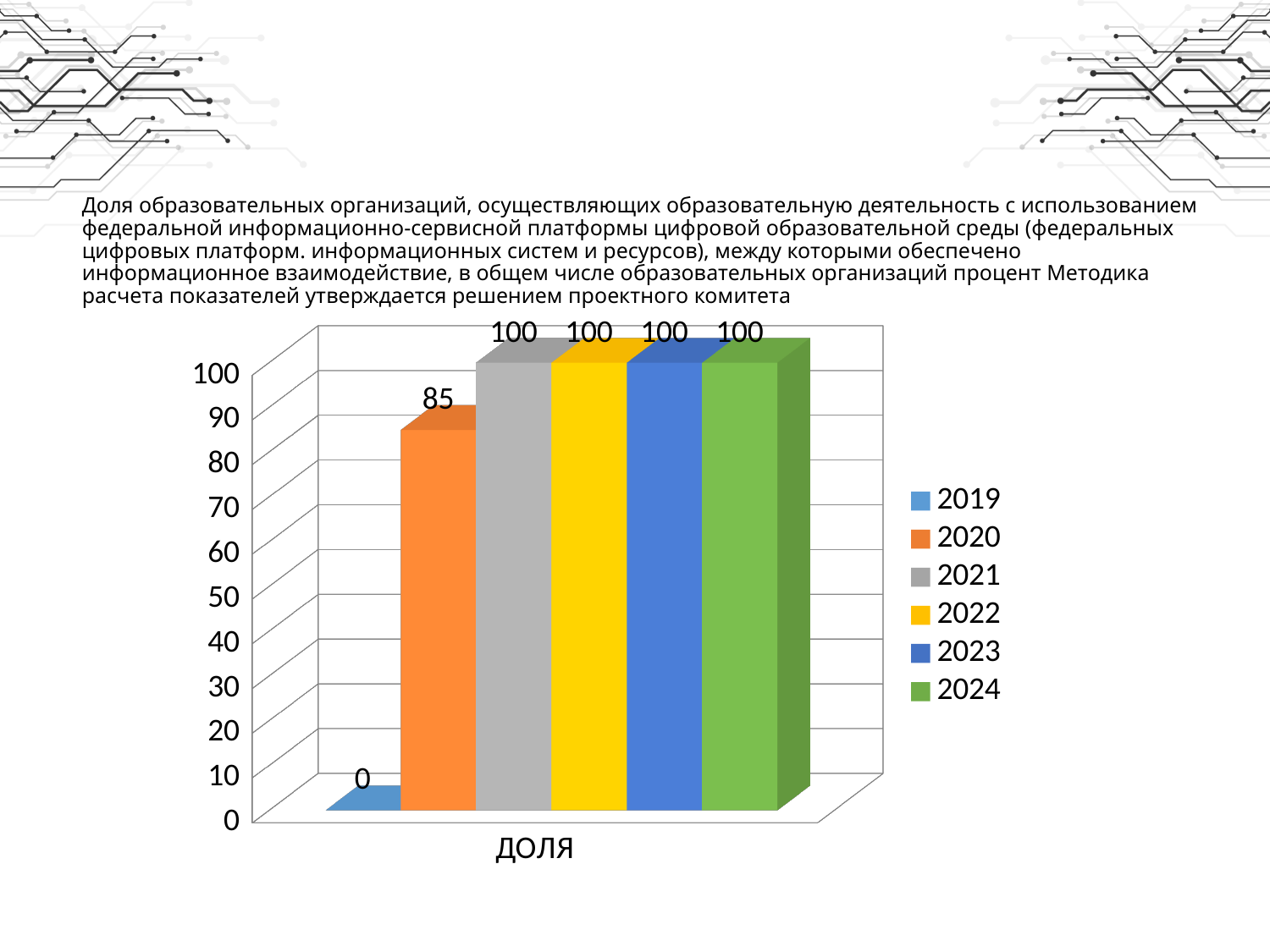
Which series has the lowest value in the chart? 2019 What is the value for the 2023 series in the chart? 100 What kind of chart is shown on the slide? bar chart What is the value for the 2020 series in the chart? 85 Which is larger, the value for 2020 or the value for 2022? 2022 What is the difference between the values for 2021 and 2020? 15 Do the values rise or fall from the 2019 series to the 2021 series? rise What is the category label shown on the x axis of the chart? ДОЛЯ Is the value for 2020 greater or less than 80? greater What is the difference between the values for 2020 and 2019? 85 How many series does the legend list? 6 What is the value for the 2019 series in the chart? 0